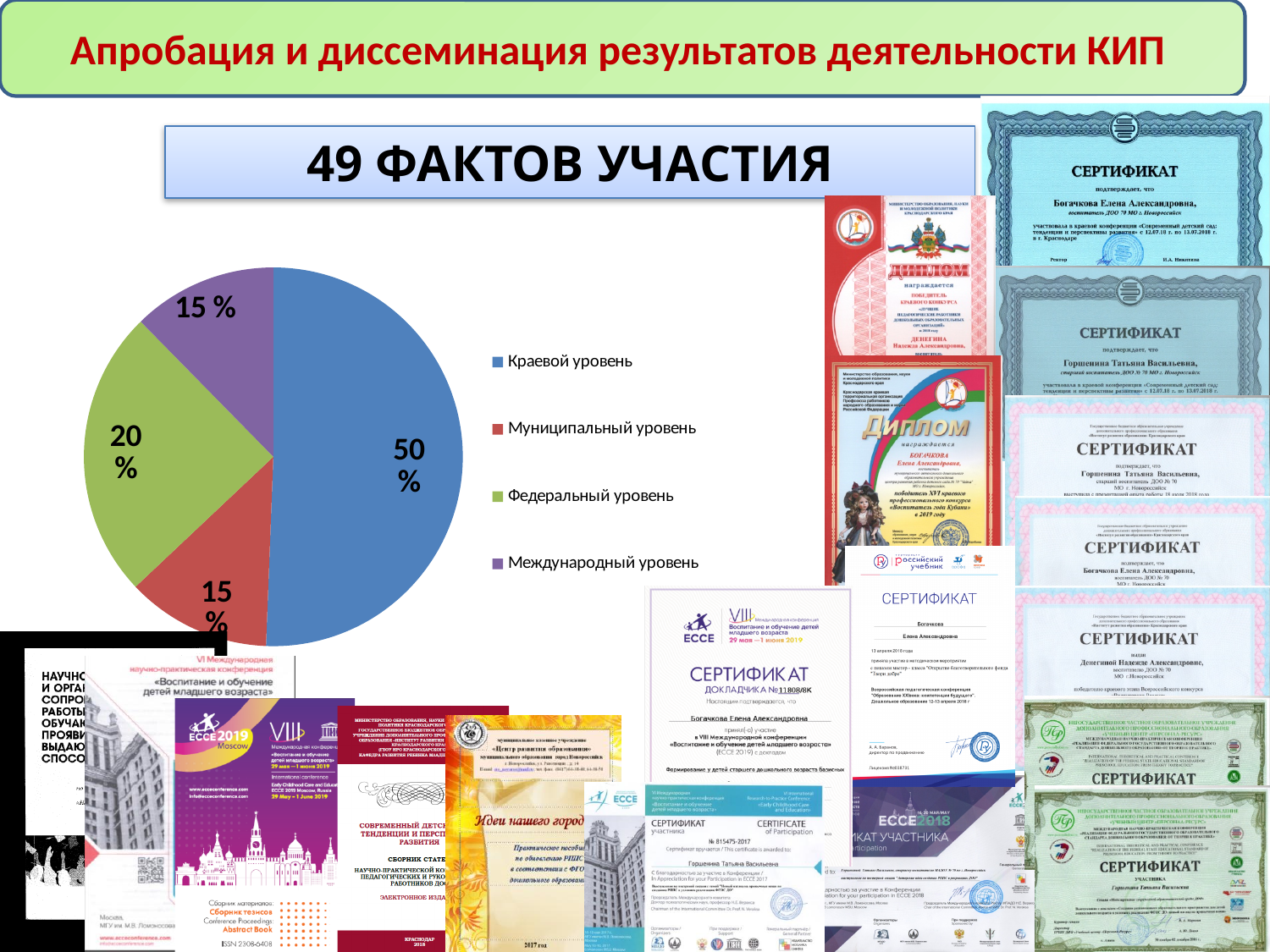
What colour is the slice for Краевой уровень? Blue What is the difference between the shares of Краевой уровень and Федеральный уровень? 30 % What share of the pie chart does Краевой уровень have? 50 % What is the total number of participation facts stated above the chart? 49 What share of the pie chart does Федеральный уровень have? 20 % Which category has the largest slice of the pie chart? Краевой уровень What share of the pie chart does Муниципальный уровень have? 15 % How many categories does the pie chart show? 4 What kind of chart is shown on the slide? Pie chart Which is larger: the share of Федеральный уровень or the share of Муниципальный уровень? Федеральный уровень What share of the pie chart does Международный уровень have? 15 % Which two categories have the same share in the pie chart? Муниципальный уровень and Международный уровень